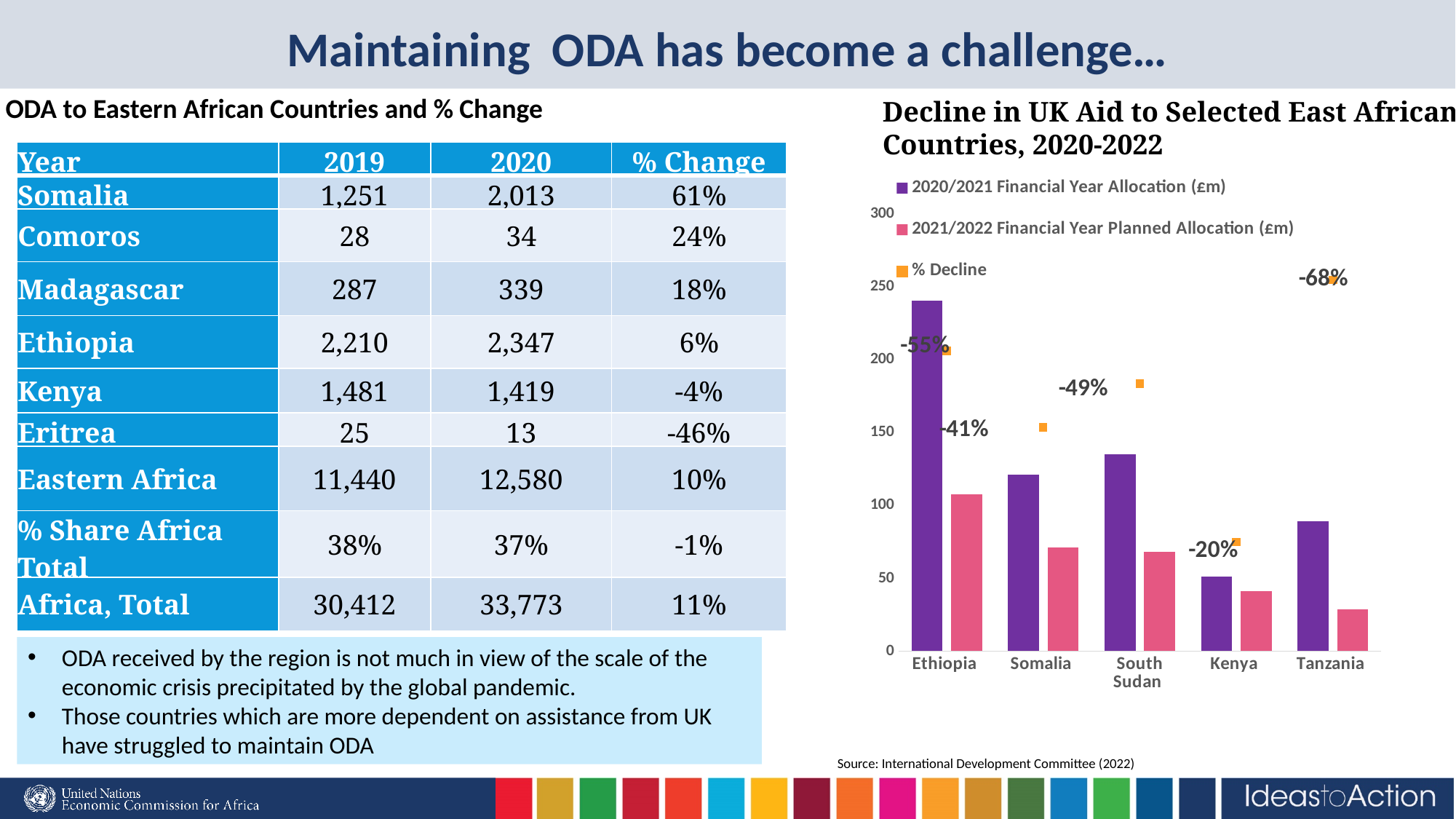
In the 'Decline in UK Aid' chart, is the 2021/2022 Financial Year Planned Allocation for Kenya greater or less than 50? less In the 'Decline in UK Aid' chart, what is the % Decline shown for Kenya? -20% What kind of chart is shown on the right side of the slide? bar chart How many entries does the legend of the 'Decline in UK Aid' chart list? 3 In the 'Decline in UK Aid' chart, which is larger: the 2020/2021 allocation for South Sudan or the 2020/2021 allocation for Somalia? South Sudan In the 'Decline in UK Aid' chart, what is the % Decline shown for Ethiopia? -55% In the 'Decline in UK Aid' chart, which country has the lowest 2021/2022 Financial Year Planned Allocation? Tanzania In the 'Decline in UK Aid' chart, what is the % Decline shown for Tanzania? -68% In the 'Decline in UK Aid' chart, which country has the highest 2020/2021 Financial Year Allocation? Ethiopia What is the title of the chart on the right side of the slide? Decline in UK Aid to Selected East African Countries, 2020-2022 In the 'Decline in UK Aid' chart, is the 2020/2021 Financial Year Allocation for Ethiopia greater or less than 200? greater How many countries are shown on the x axis of the 'Decline in UK Aid' chart? 5